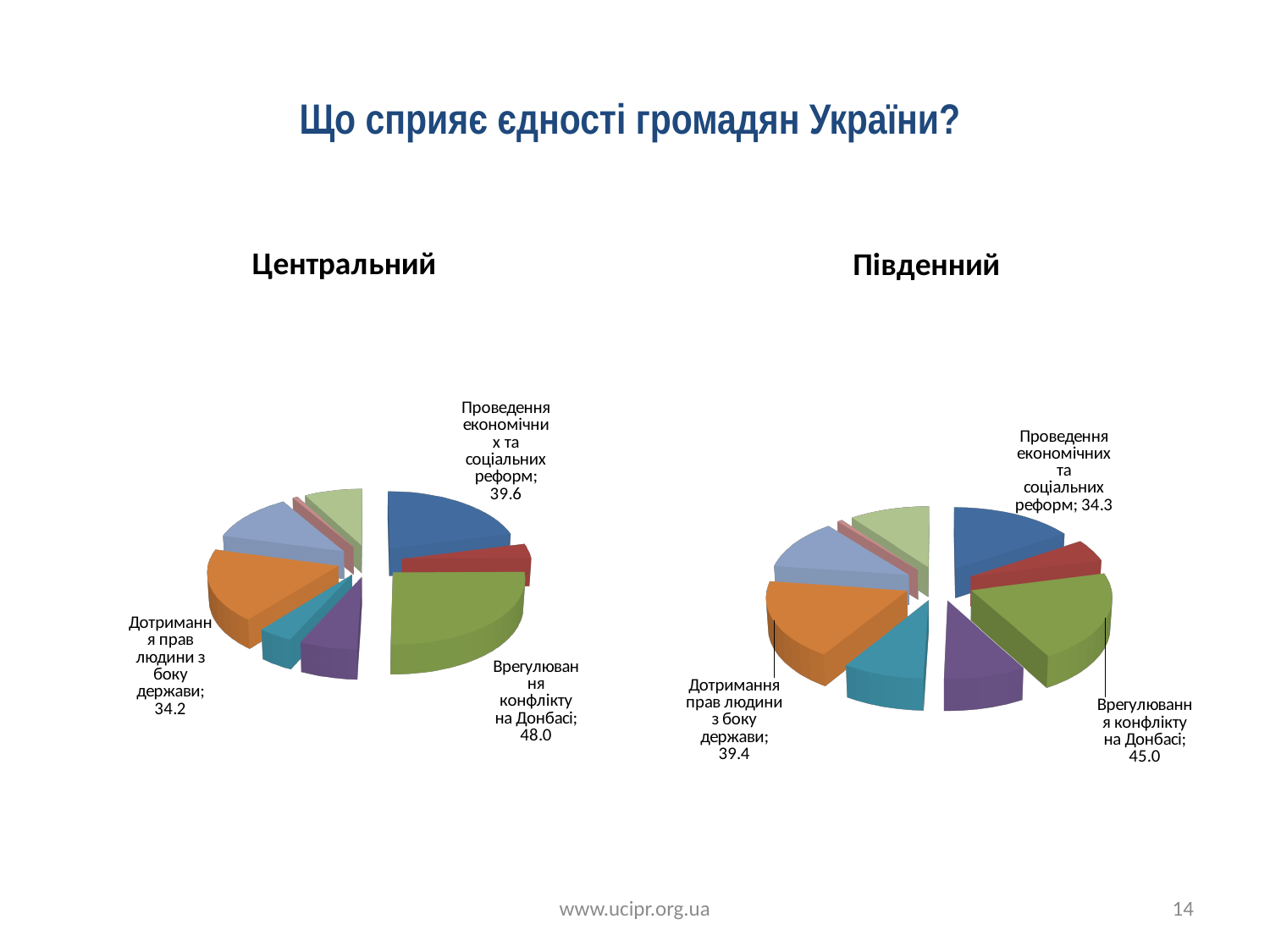
What type of chart is used for the Центральний data? Pie chart In the Центральний chart, what value is shown for Проведення економічних та соціальних реформ? 39.6 In the Південний chart, what value is shown for Дотримання прав людини з боку держави? 39.4 In the Центральний chart, what value is shown for Дотримання прав людини з боку держави? 34.2 In the Центральний chart, which labelled category has the largest value? Врегулювання конфлікту на Донбасі What is the difference between the value for Врегулювання конфлікту на Донбасі in the Центральний chart and in the Південний chart? 3.0 In the Південний chart, which labelled category has the smallest value? Проведення економічних та соціальних реформ In the Південний chart, what value is shown for Врегулювання конфлікту на Донбасі? 45.0 What is the title of the slide above the two charts? Що сприяє єдності громадян України? Is the value for Дотримання прав людини з боку держави larger in the Центральний chart or in the Південний chart? Південний In the Центральний chart, what value is shown for Врегулювання конфлікту на Донбасі? 48.0 In the Південний chart, what value is shown for Проведення економічних та соціальних реформ? 34.3